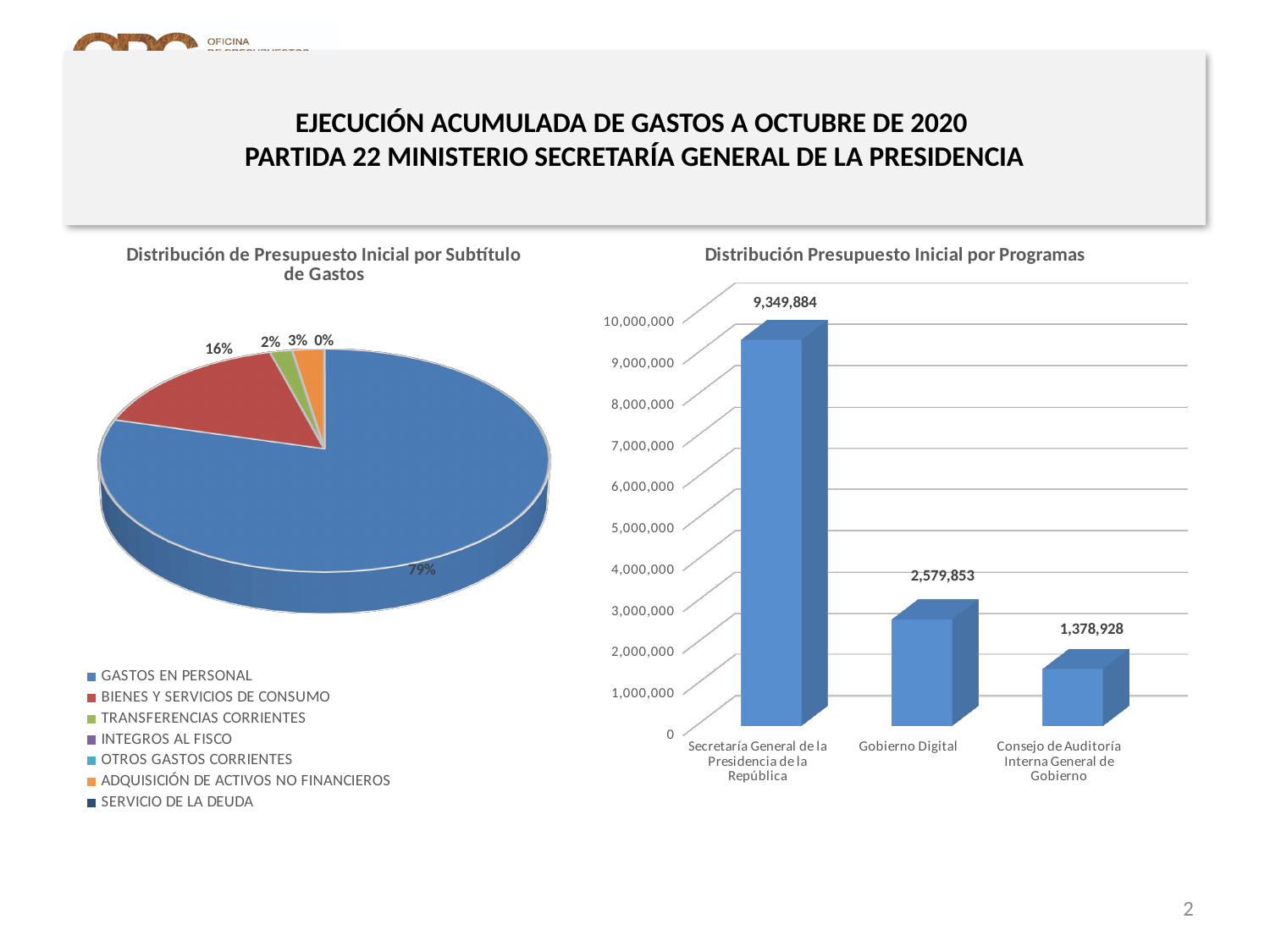
In the chart 'Distribución Presupuesto Inicial por Programas', what is the difference between Secretaría General de la Presidencia de la República and Gobierno Digital? 6,770,031 In the chart 'Distribución Presupuesto Inicial por Programas', what is the difference between Gobierno Digital and Consejo de Auditoría Interna General de Gobierno? 1,200,925 In the chart 'Distribución Presupuesto Inicial por Programas', which program has the highest value? Secretaría General de la Presidencia de la República In the pie chart 'Distribución de Presupuesto Inicial por Subtítulo de Gastos', what share does BIENES Y SERVICIOS DE CONSUMO have? 16% In the chart 'Distribución Presupuesto Inicial por Programas', which program has the lowest value? Consejo de Auditoría Interna General de Gobierno What kind of chart is 'Distribución Presupuesto Inicial por Programas'? Bar chart In the pie chart 'Distribución de Presupuesto Inicial por Subtítulo de Gastos', what share does GASTOS EN PERSONAL have? 79% In the chart 'Distribución Presupuesto Inicial por Programas', how many programs are shown? 3 In the chart 'Distribución Presupuesto Inicial por Programas', what is the value for Consejo de Auditoría Interna General de Gobierno? 1,378,928 In the chart 'Distribución Presupuesto Inicial por Programas', what is the value for Secretaría General de la Presidencia de la República? 9,349,884 In the chart 'Distribución Presupuesto Inicial por Programas', what is the value for Gobierno Digital? 2,579,853 How many entries does the legend of the pie chart 'Distribución de Presupuesto Inicial por Subtítulo de Gastos' list? 7